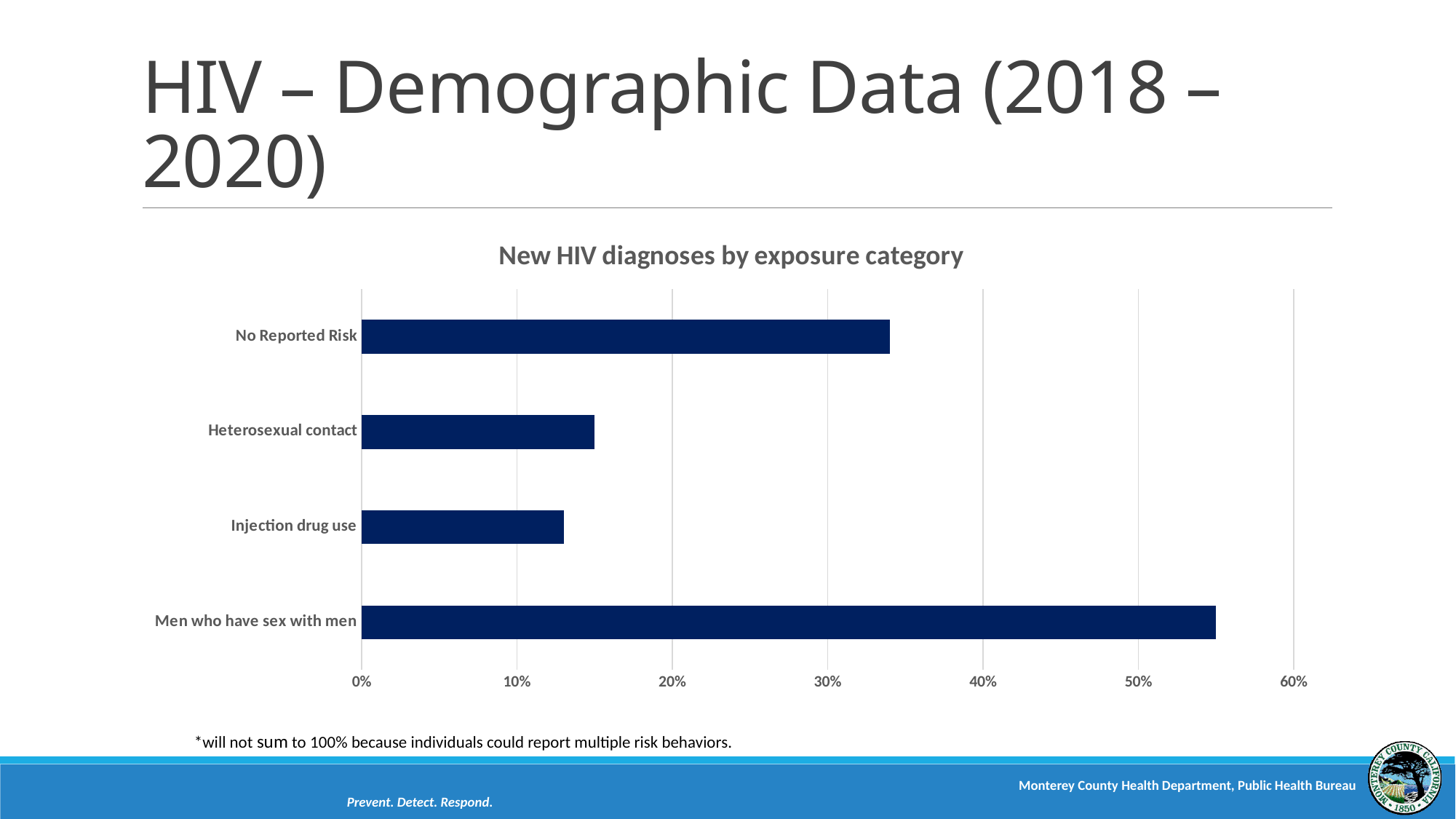
Is the value for Men who have sex with men greater or less than 50%? greater Which exposure category has the highest share of new HIV diagnoses? Men who have sex with men Which is larger, the value for No Reported Risk or the value for Heterosexual contact? No Reported Risk What type of chart is shown on the slide? bar chart Which is larger, the value for Men who have sex with men or the value for No Reported Risk? Men who have sex with men What is the maximum value shown on the horizontal axis of the chart? 60% Which exposure category has the lowest share of new HIV diagnoses? Injection drug use Is the value for Injection drug use greater or less than 10%? greater What is the title of the chart? New HIV diagnoses by exposure category How many exposure categories are shown in the chart? 4 Is the value for Heterosexual contact greater or less than 20%? less